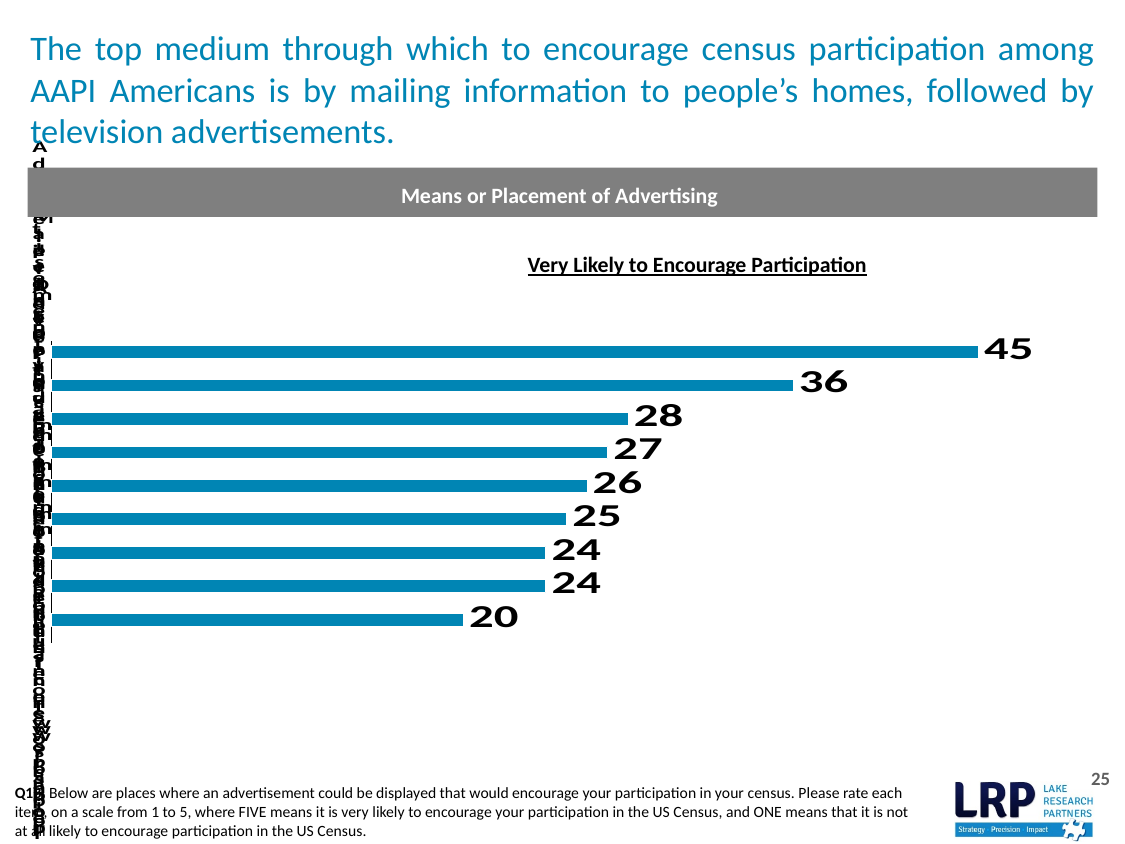
What is the value of the second bar from the top? 36 What is the value of the bottom bar in the chart? 20 How many bars are plotted in the chart? 9 What is the highest value shown in the chart? 45 What is the difference between the top bar (45) and the second bar (36)? 9 Do the bar values increase or decrease going from the top bar to the bottom bar? decrease What is the difference between the highest value (45) and the lowest value (20)? 25 What kind of chart is shown on the slide? bar chart What is the title shown in the grey header bar above the chart? Means or Placement of Advertising What is the lowest value shown in the chart? 20 Which is larger, the value of the third bar from the top or the value of the bottom bar? the third bar from the top (28) What is the value of the top bar in the chart? 45